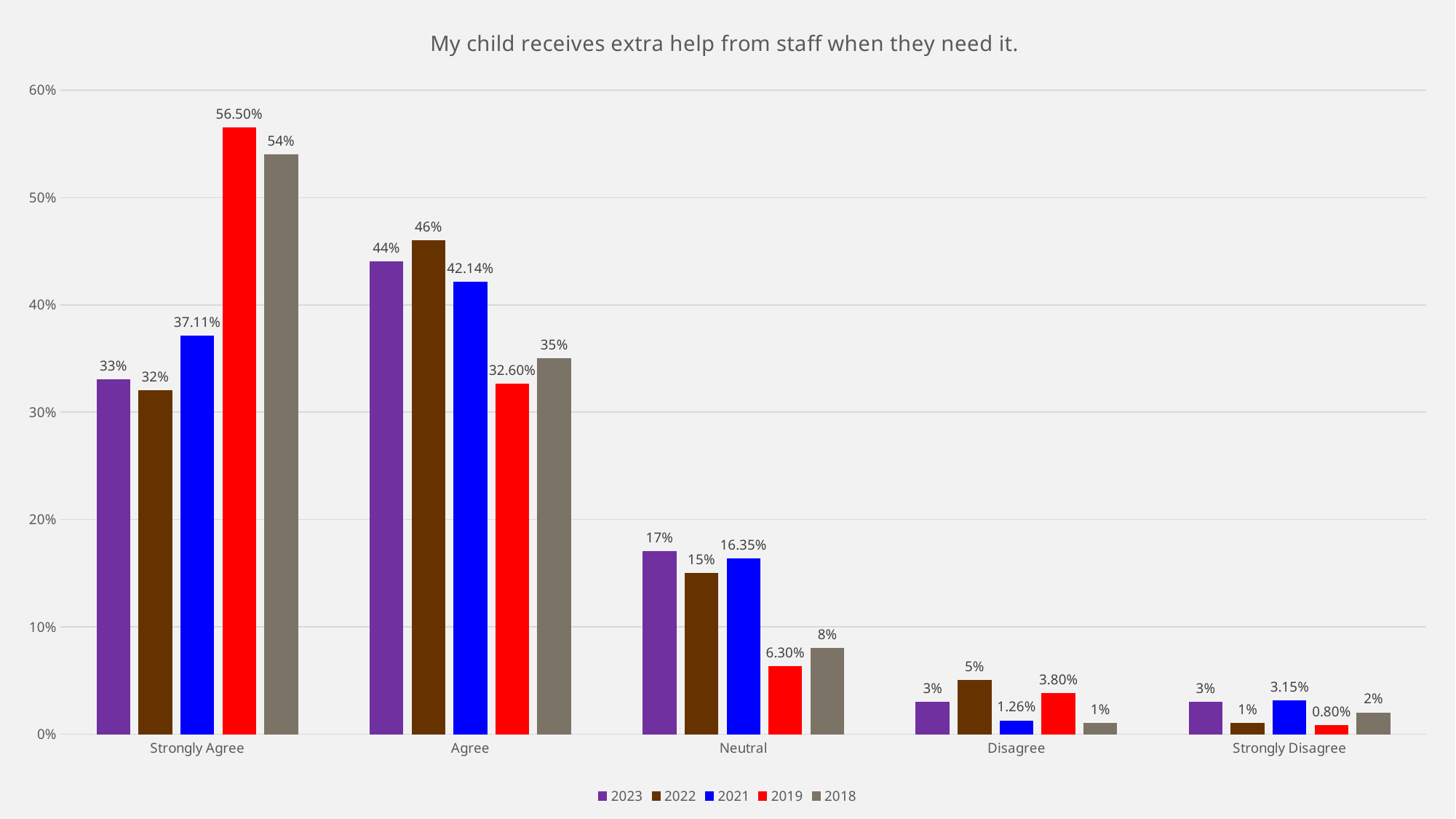
What is the value for 2021 in the Agree category? 42.14% Which series has the highest value in the Strongly Agree category? 2019 Which series has the lowest value in the Disagree category? 2018 How many categories are shown on the x axis? 5 Which is larger in the Neutral category: the 2023 value or the 2021 value? 2023 What is the value for 2019 in the Strongly Agree category? 56.50% What is the title of the chart? My child receives extra help from staff when they need it. What is the value for 2018 in the Neutral category? 8% How many series does the legend list? 5 What kind of chart is shown on the slide? bar chart Is the value for 2018 in the Agree category greater or less than 40%? less What is the difference between the 2022 and 2019 values in the Agree category? 13.40%